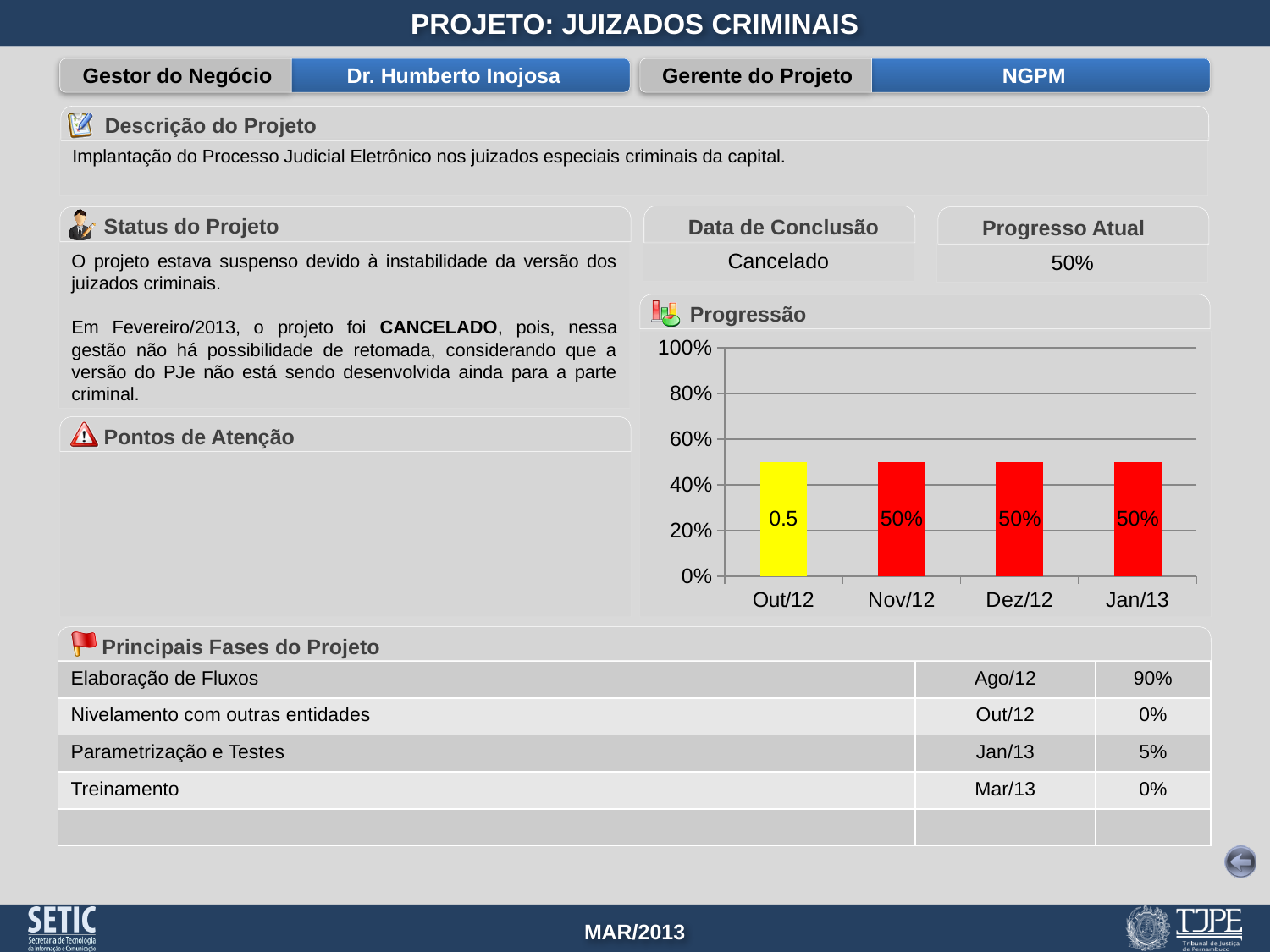
What kind of chart is the Progressão chart? bar chart What is the value for Nov/12 in the Progressão chart? 50% What is the value for Dez/12 in the Progressão chart? 50% What is the difference between the Dez/12 and Nov/12 values in the Progressão chart? 0% Is the value for Nov/12 in the Progressão chart greater or less than 20%? greater What colour is the Out/12 bar in the Progressão chart? yellow What is the title of the chart on the slide? Progressão What is the value for Jan/13 in the Progressão chart? 50% How many categories are plotted on the x axis of the Progressão chart? 4 Do the values in the Progressão chart rise, fall or stay flat from Nov/12 to Jan/13? stay flat Is the value for Jan/13 in the Progressão chart greater or less than 80%? less What is the data label shown on the Out/12 bar in the Progressão chart? 0.5